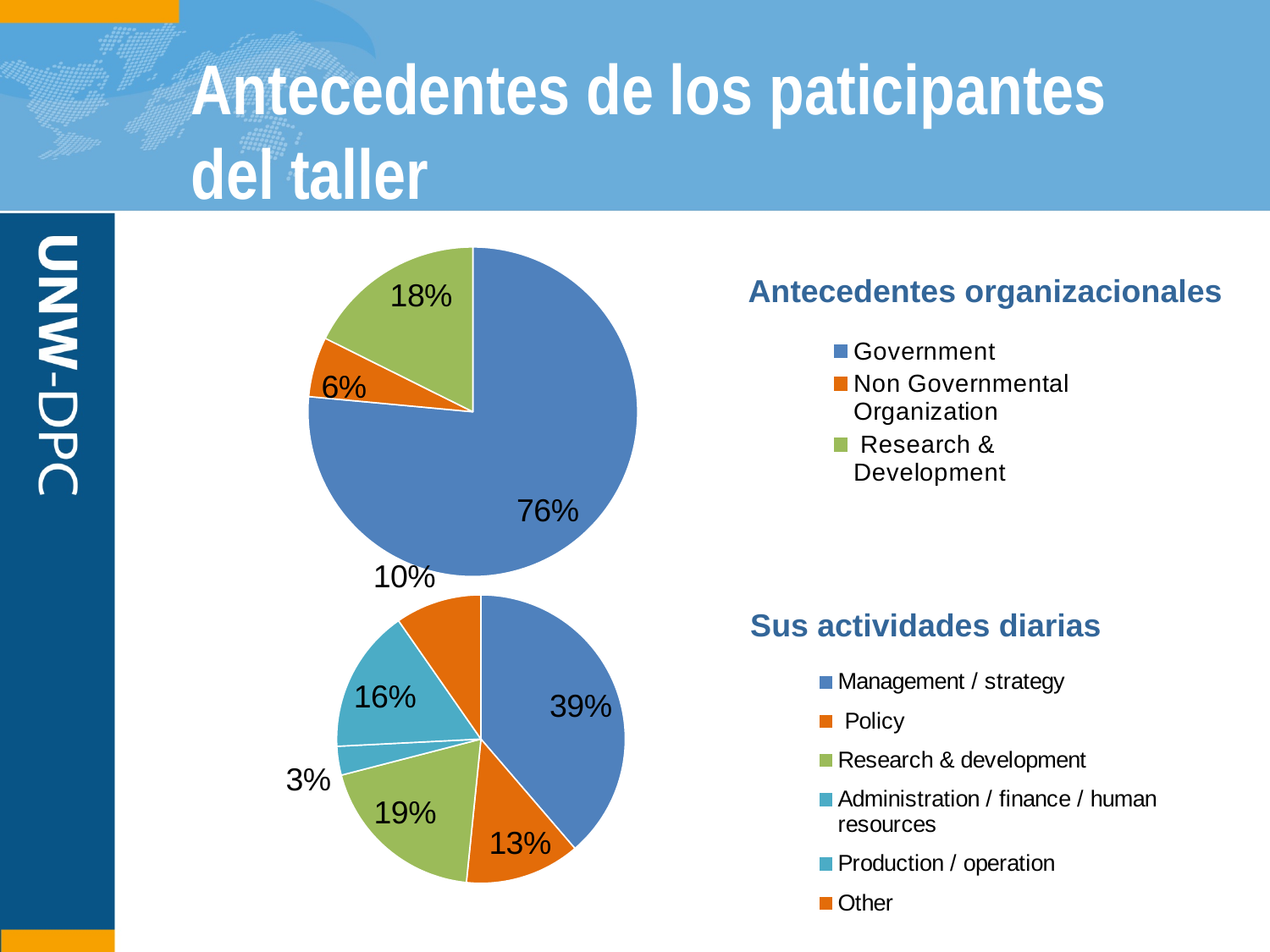
In the 'Antecedentes organizacionales' pie chart, which category has the smallest slice? Non Governmental Organization In the 'Sus actividades diarias' pie chart, what share is Management / strategy? 39% In the 'Antecedentes organizacionales' pie chart, what share is Government? 76% In the 'Sus actividades diarias' pie chart, what share is Research & development? 19% In the 'Sus actividades diarias' pie chart, which category has the largest slice? Management / strategy How many categories does the legend of the 'Sus actividades diarias' chart list? 6 In the 'Antecedentes organizacionales' pie chart, what share is Research & Development? 18% In the 'Antecedentes organizacionales' pie chart, what share is Non Governmental Organization? 6% In the 'Sus actividades diarias' pie chart, what share is Policy? 13% In the 'Antecedentes organizacionales' pie chart, which category has the largest slice? Government How many categories does the legend of the 'Antecedentes organizacionales' chart list? 3 In the 'Antecedentes organizacionales' pie chart, what is the difference between the Government and Research & Development shares? 58%